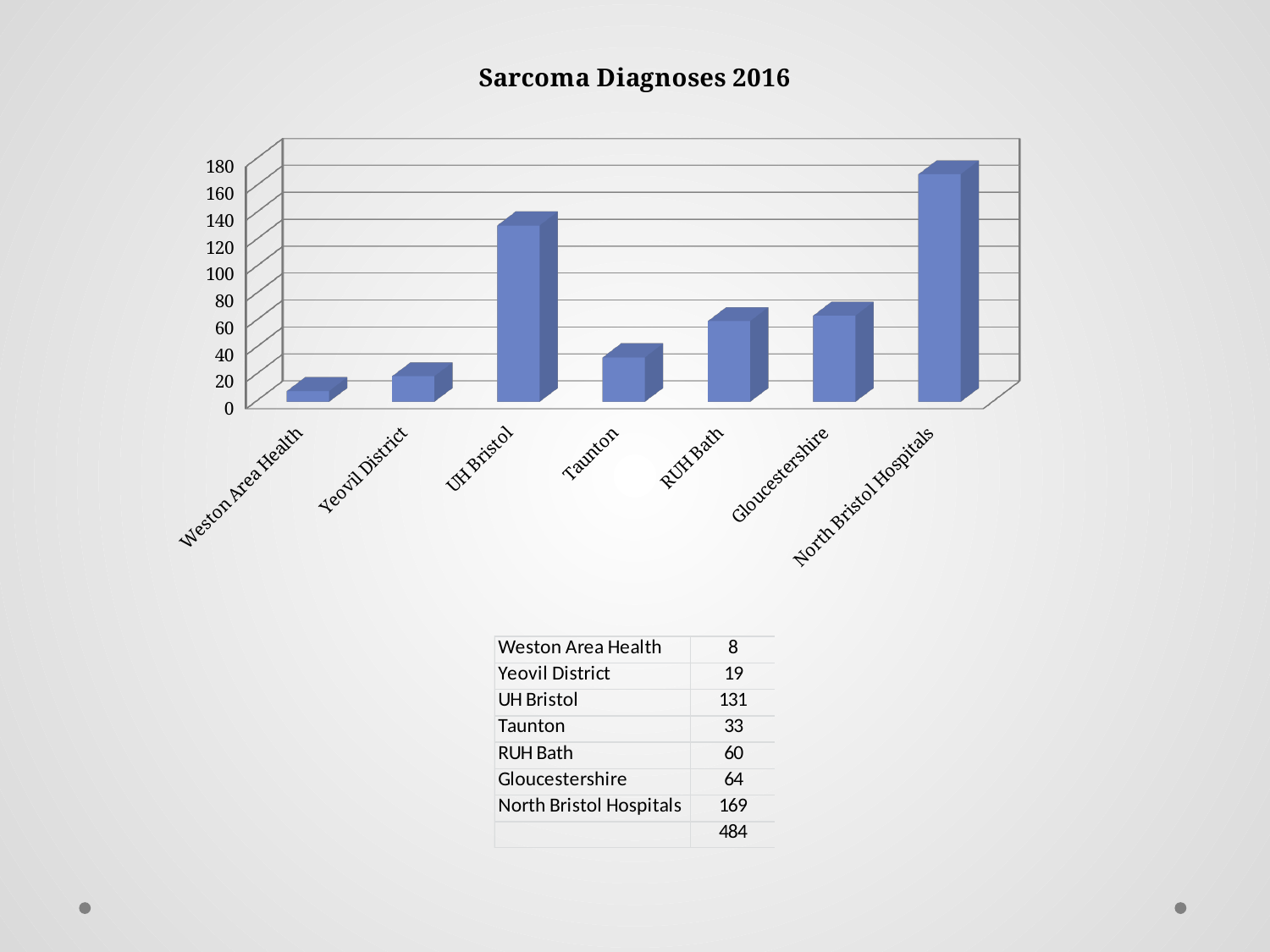
Which is larger, the value for RUH Bath or the value for Taunton? RUH Bath What is the value for Taunton? 33 Which category has the highest value? North Bristol Hospitals What is the value for UH Bristol? 131 What kind of chart is shown on the slide? bar chart What is the title of the chart? Sarcoma Diagnoses 2016 What is the total of all the values shown in the table? 484 What is the value for North Bristol Hospitals? 169 Is the value for Yeovil District greater or less than 40? less What is the difference between the values for North Bristol Hospitals and UH Bristol? 38 Which category has the lowest value? Weston Area Health How many categories are plotted on the chart? 7